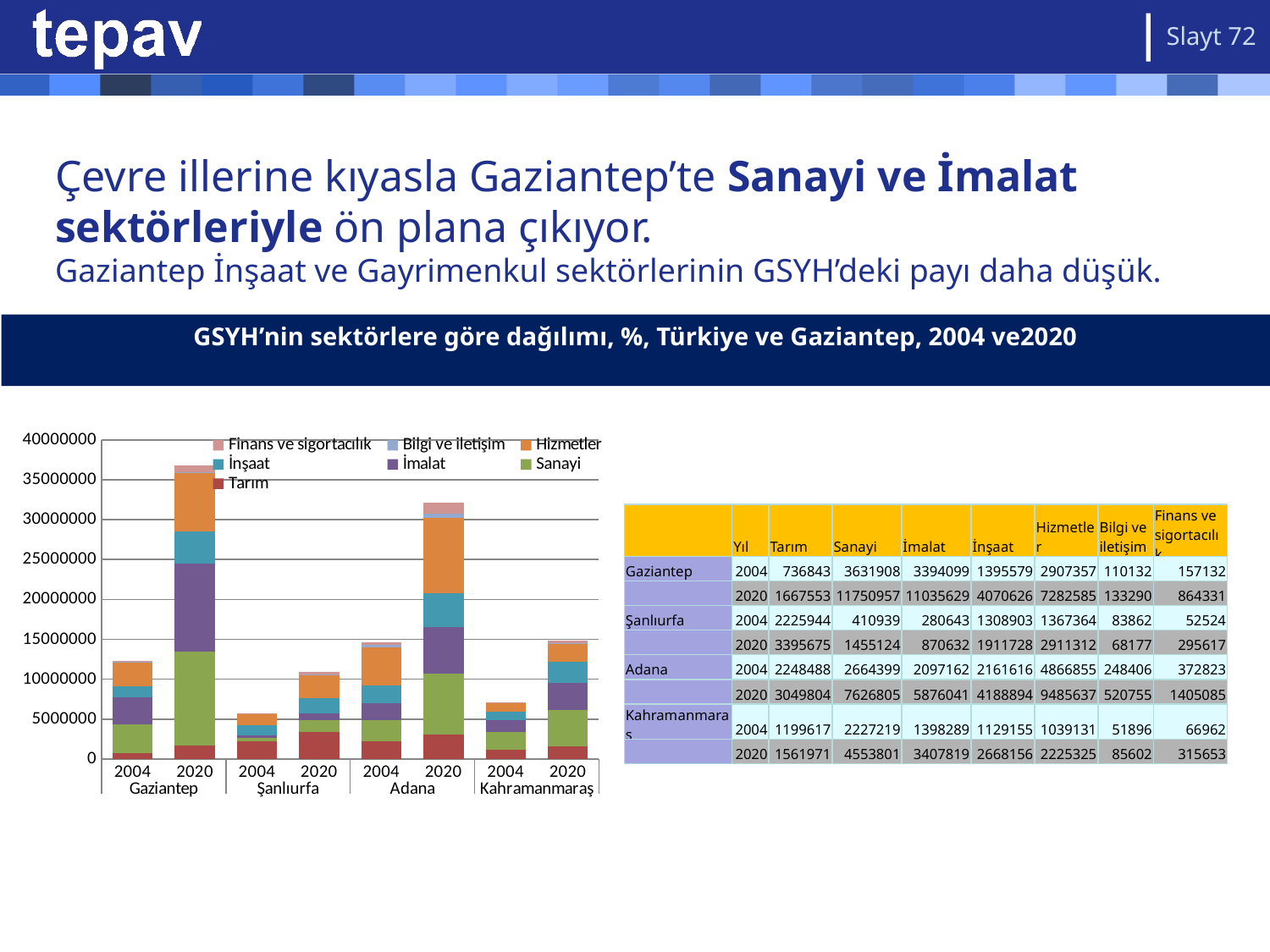
What kind of chart is shown on the slide? Stacked bar chart Which colour represents Sanayi in the chart legend? Green Which bar is taller, Adana 2020 or Gaziantep 2020? Gaziantep 2020 According to the table on the slide, what is the Sanayi value for Gaziantep in 2020? 11750957 How many series does the chart legend list? 7 According to the table on the slide, what is the difference between the Sanayi values for Gaziantep in 2020 and 2004? 8119049 How many stacked bars are plotted in the chart? 8 Is the total of the Kahramanmaraş 2004 bar greater or less than 10000000? less For each province, does the bar rise or fall from 2004 to 2020? Rise Is the total of the Gaziantep 2020 bar greater or less than 35000000? greater Which bar is the tallest in the chart? Gaziantep 2020 Which bar is the shortest in the chart? Şanlıurfa 2004